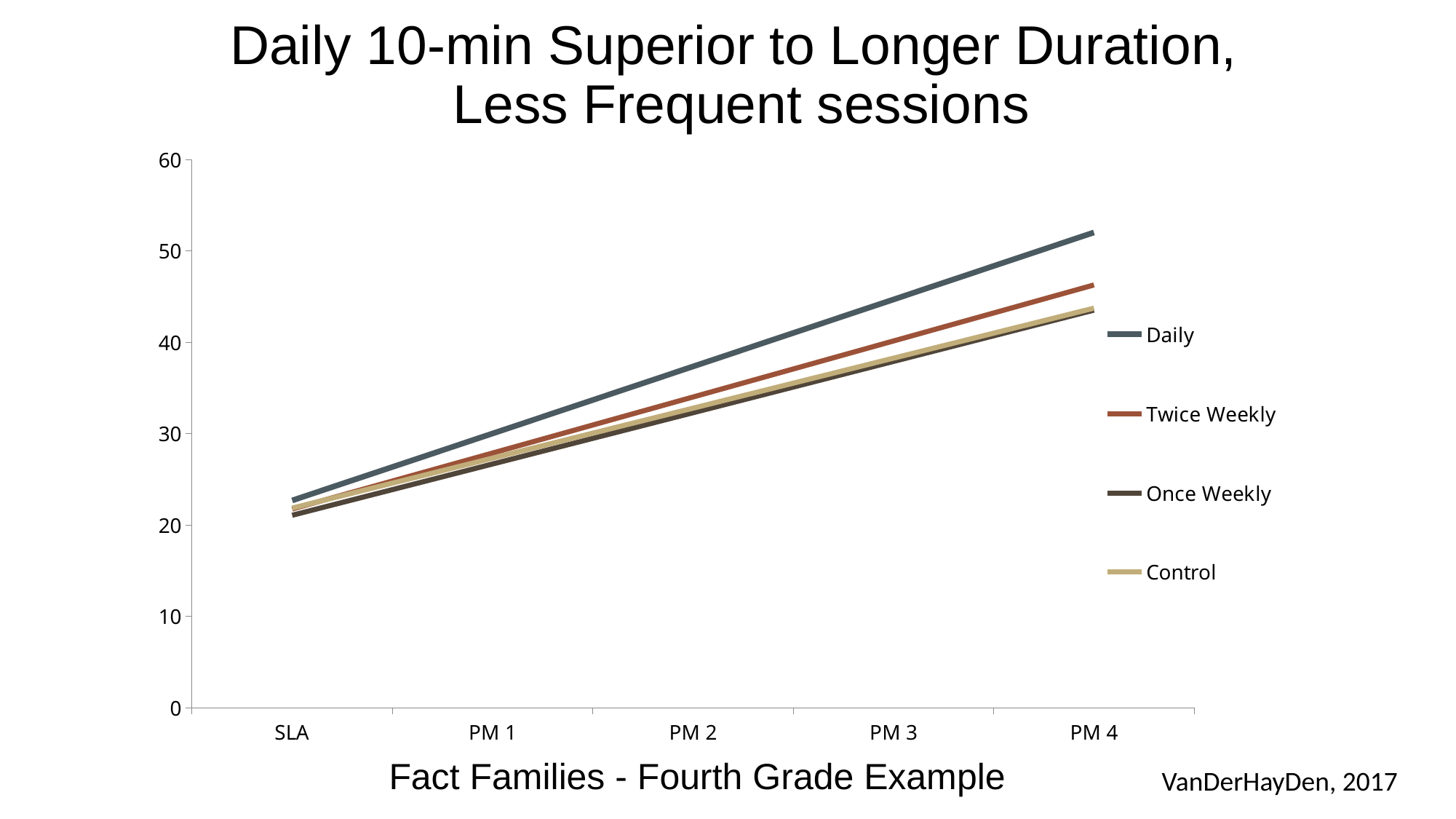
Do the values for the Daily series rise or fall from SLA to PM 4? rise Which series is shown in red? Twice Weekly How many series does the legend list? 4 How many points are labelled along the x axis? 5 Is the value for Once Weekly at PM 4 greater or less than 40? greater Which series has the highest value at PM 4? Daily Is the value for Twice Weekly at PM 4 greater or less than 50? less What kind of chart is shown on the slide? line chart What is the x-axis title of the chart? Fact Families - Fourth Grade Example Is the value for Daily at PM 4 greater or less than 50? greater At PM 4, which is larger: Daily or Twice Weekly? Daily